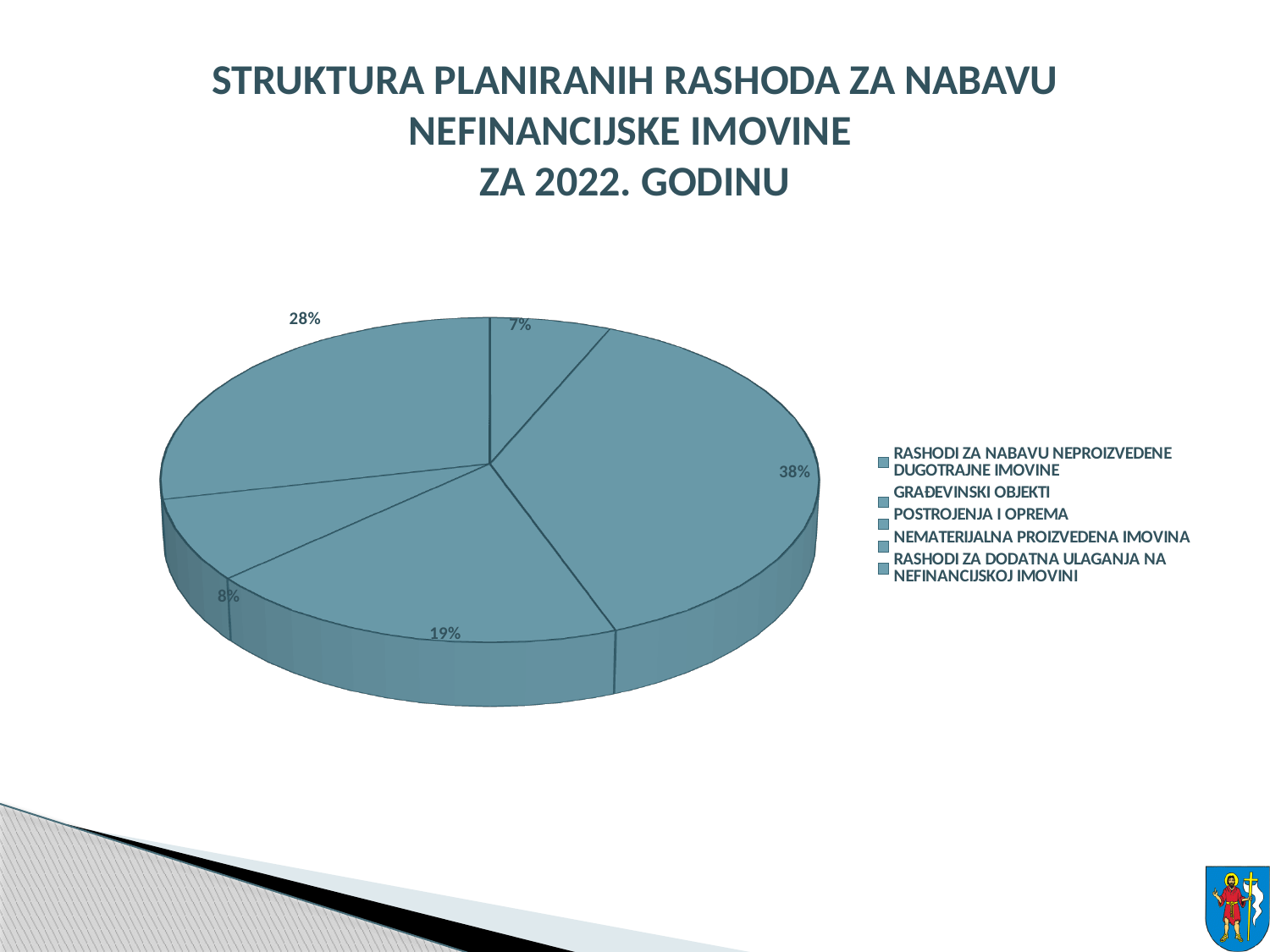
What type of chart is shown on the slide? pie chart What is the percentage of the smallest slice in the pie chart? 7% Is the largest slice of the pie chart greater or less than 30%? greater What is the percentage of the largest slice in the pie chart? 38% How many slices does the pie chart have? 5 What year does the chart title refer to? 2022 What is the combined share of the two smallest slices (7% and 8%)? 15% What is the difference in percentage points between the largest slice (38%) and the second-largest slice (28%)? 10 How many entries does the legend of the pie chart list? 5 What is the second legend entry of the pie chart? GRAĐEVINSKI OBJEKTI Which is larger: the slice labelled 19% or the slice labelled 8%? 19%